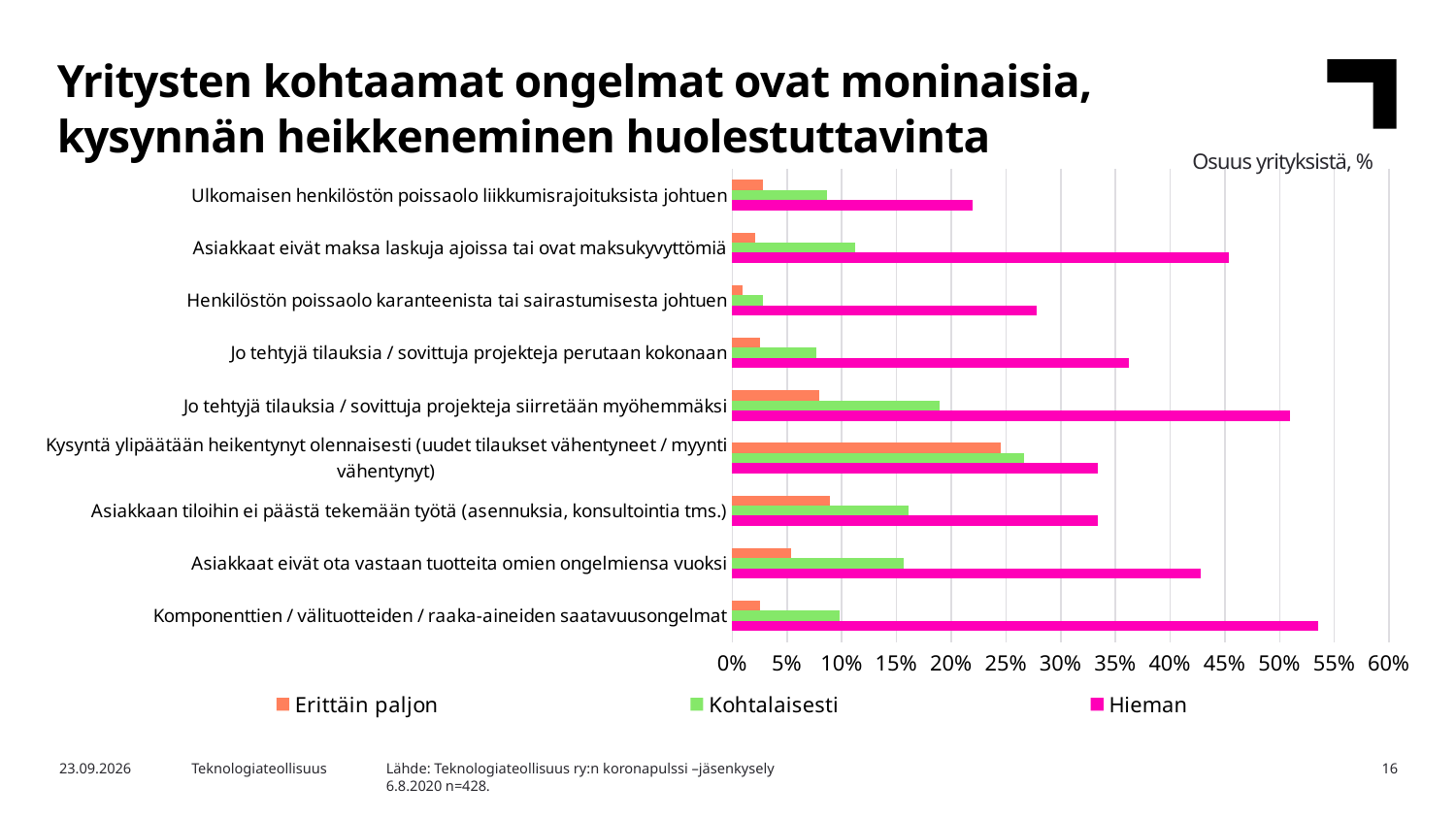
Is the 'Hieman' value for 'Asiakkaat eivät maksa laskuja ajoissa tai ovat maksukyvyttömiä' greater or less than 40%? greater Which category has the highest value for the 'Erittäin paljon' series? Kysyntä ylipäätään heikentynyt olennaisesti (uudet tilaukset vähentyneet / myynti vähentynyt) How many categories (problem types) are plotted on the chart? 9 Is the 'Kohtalaisesti' value for 'Kysyntä ylipäätään heikentynyt olennaisesti' greater or less than 20%? greater Which category has the highest value for the 'Hieman' series? Komponenttien / välituotteiden / raaka-aineiden saatavuusongelmat For 'Komponenttien / välituotteiden / raaka-aineiden saatavuusongelmat', which series has the larger value: 'Hieman' or 'Kohtalaisesti'? Hieman How many series does the legend list? 3 Which category has the lowest value for the 'Hieman' series? Ulkomaisen henkilöstön poissaolo liikkumisrajoituksista johtuen Which category has the lowest value for the 'Erittäin paljon' series? Henkilöstön poissaolo karanteenista tai sairastumisesta johtuen What label is shown above the chart to indicate what the values represent? Osuus yrityksistä, % What kind of chart is shown on the slide? Bar chart Is the 'Hieman' value for 'Ulkomaisen henkilöstön poissaolo liikkumisrajoituksista johtuen' greater or less than 25%? less